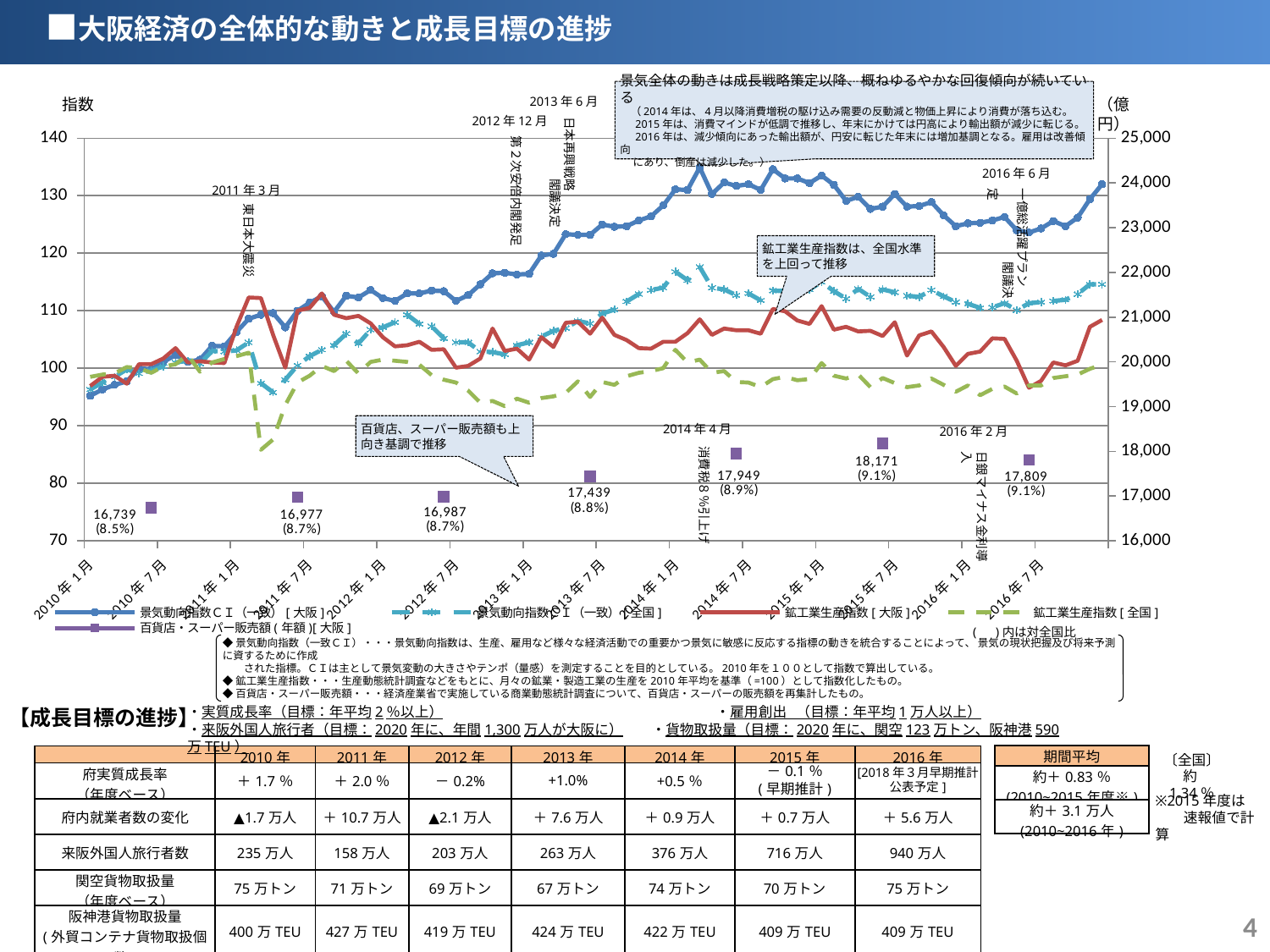
Which is larger, the 百貨店・スーパー販売額 value labeled 17,949 or the one labeled 17,809? 17,949 How many series does the chart legend list? 5 What is the lowest labeled value for 百貨店・スーパー販売額(年額)[大阪] on the chart? 16,739 How many labeled data points are plotted for 百貨店・スーパー販売額(年額)[大阪]? 7 What is the maximum value shown on the right vertical axis (億円)? 25,000 Is the value of 景気動向指数CI（一致）[大阪] at 2016年7月 greater or less than 120? greater What kind of chart is shown on the slide? line chart What is the difference between the highest and lowest labeled values of 百貨店・スーパー販売額(年額)[大阪] (18,171 and 16,739)? 1,432 What percentage (対全国比) is shown in parentheses under the 百貨店・スーパー販売額 value 16,739? 8.5% What percentage (対全国比) is shown in parentheses under the 百貨店・スーパー販売額 value 18,171? 9.1% What is the maximum value shown on the left vertical axis (指数)? 140 What is the highest labeled value for 百貨店・スーパー販売額(年額)[大阪] on the chart? 18,171